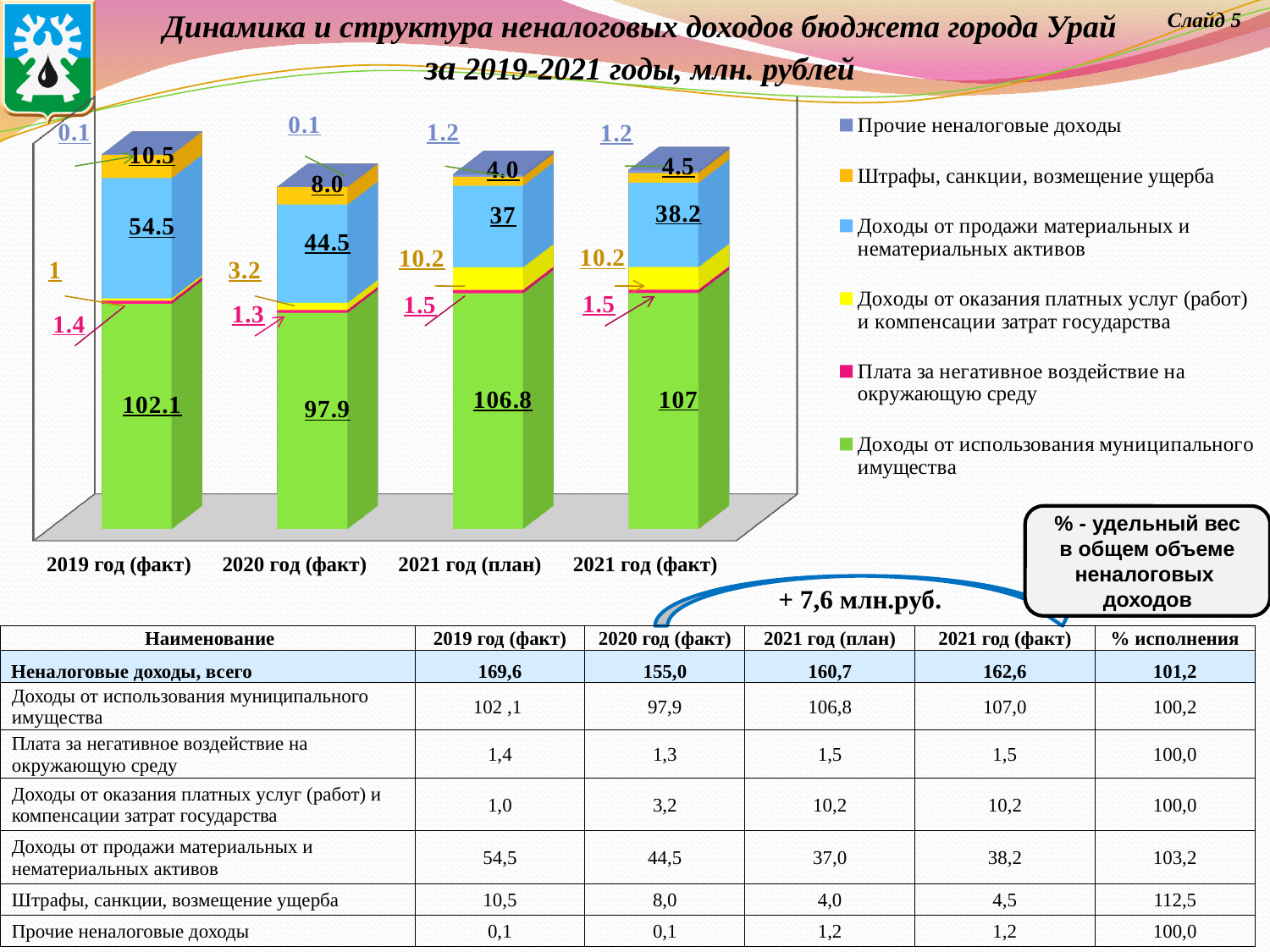
How many categories (years) are shown on the x axis of the chart? 4 What is the total of the stacked bar for 2019 год (факт)? 169.6 What is the value for Доходы от продажи материальных и нематериальных активов in 2021 год (план)? 37 Do the values for Доходы от оказания платных услуг (работ) и компенсации затрат государства rise or fall from 2019 год (факт) to 2021 год (факт)? Rise In which year is the value for Доходы от использования муниципального имущества the lowest? 2020 год (факт) How many series does the chart legend list? 6 What is the difference between the Доходы от продажи материальных и нематериальных активов values for 2019 год (факт) and 2020 год (факт)? 10 In which year is the value for Доходы от продажи материальных и нематериальных активов the highest? 2019 год (факт) What is the value for Доходы от использования муниципального имущества in 2019 год (факт)? 102.1 What is the value for Штрафы, санкции, возмещение ущерба in 2020 год (факт)? 8.0 What kind of chart is shown on the slide? Stacked bar chart Which is larger for Штрафы, санкции, возмещение ущерба: 2019 год (факт) or 2021 год (факт)? 2019 год (факт)